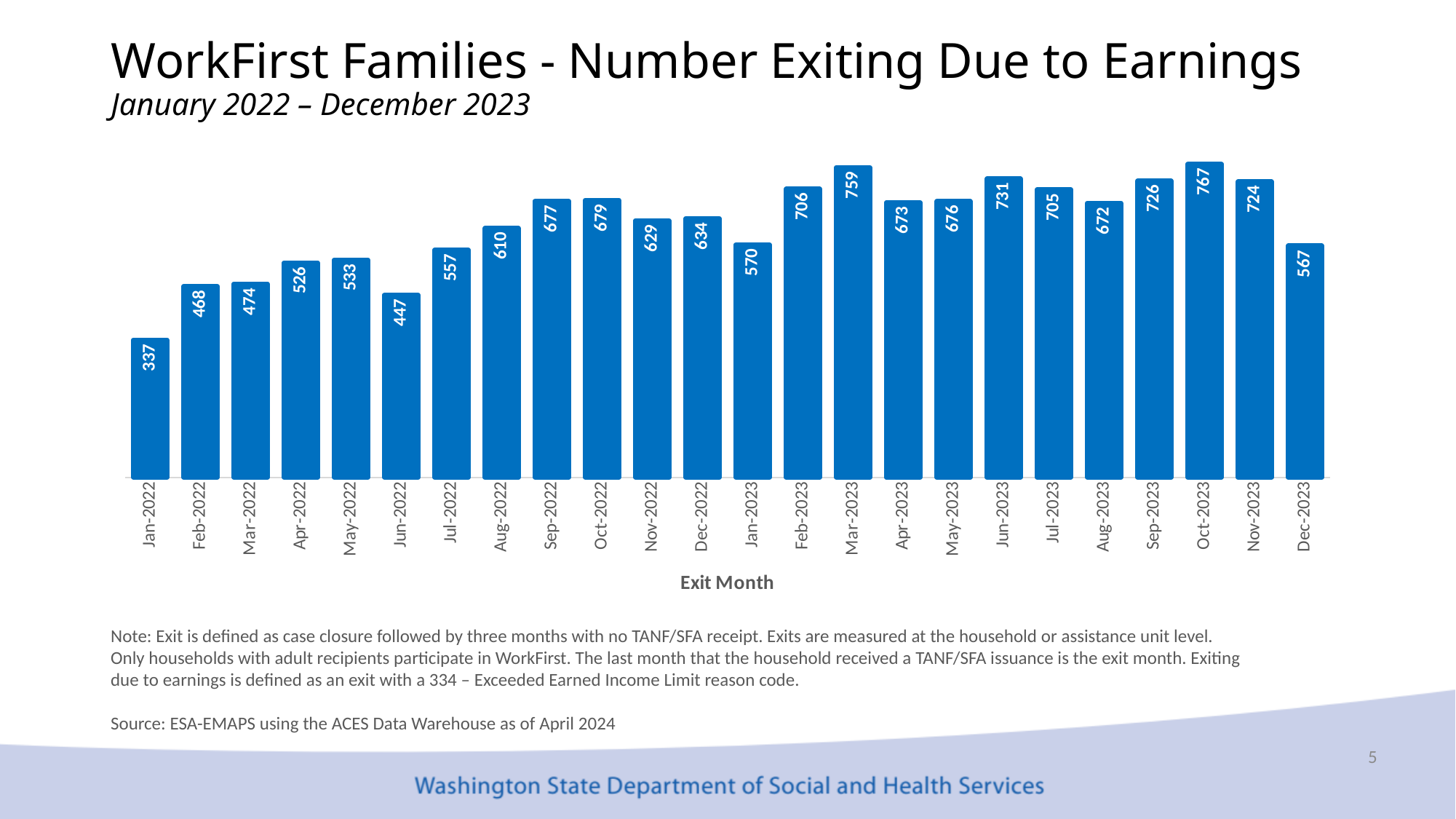
What is the value shown for Dec-2023? 567 Which month has the highest number of exits due to earnings? Oct-2023 How many months are plotted on the chart? 24 What is the value shown for Mar-2023? 759 What is the number of WorkFirst families exiting due to earnings in Jan-2022? 337 Do the values generally rise or fall from Jan-2022 to Oct-2023? Rise Which month has the lowest number of exits due to earnings? Jan-2022 What kind of chart is shown on the slide? Bar chart What is the label of the x axis? Exit Month Which is larger, the value for Sep-2022 or the value for Nov-2022? Sep-2022 What is the difference between the values for Oct-2023 and Jan-2022? 430 What is the difference between the values for Jun-2022 and Jul-2022? 110